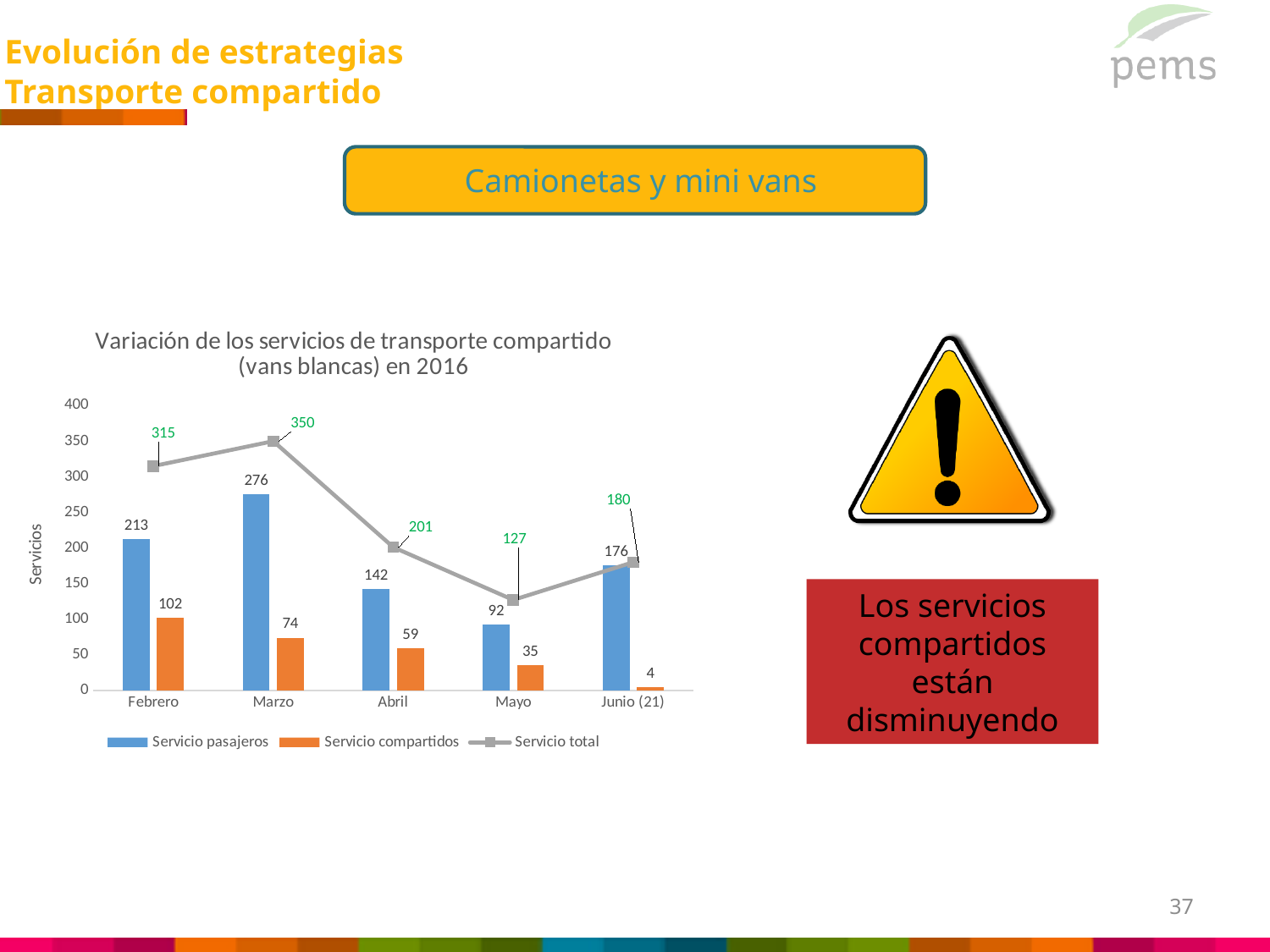
Does Servicio compartidos rise or fall from Febrero to Junio (21)? Fall Which month has the highest Servicio total? Marzo What is the difference between Servicio pasajeros and Servicio compartidos in Febrero? 111 Which is larger, Servicio pasajeros in Mayo or Servicio pasajeros in Junio (21)? Junio (21) What is the value of Servicio total for Abril? 201 How many series does the legend list? 3 What kind of chart is used for the Servicio pasajeros and Servicio compartidos series? Bar chart How many months are shown on the x axis? 5 What is the value of Servicio compartidos for Junio (21)? 4 Which month has the lowest Servicio compartidos? Junio (21) What is the value of Servicio pasajeros for Marzo? 276 What is the title of the chart? Variación de los servicios de transporte compartido (vans blancas) en 2016